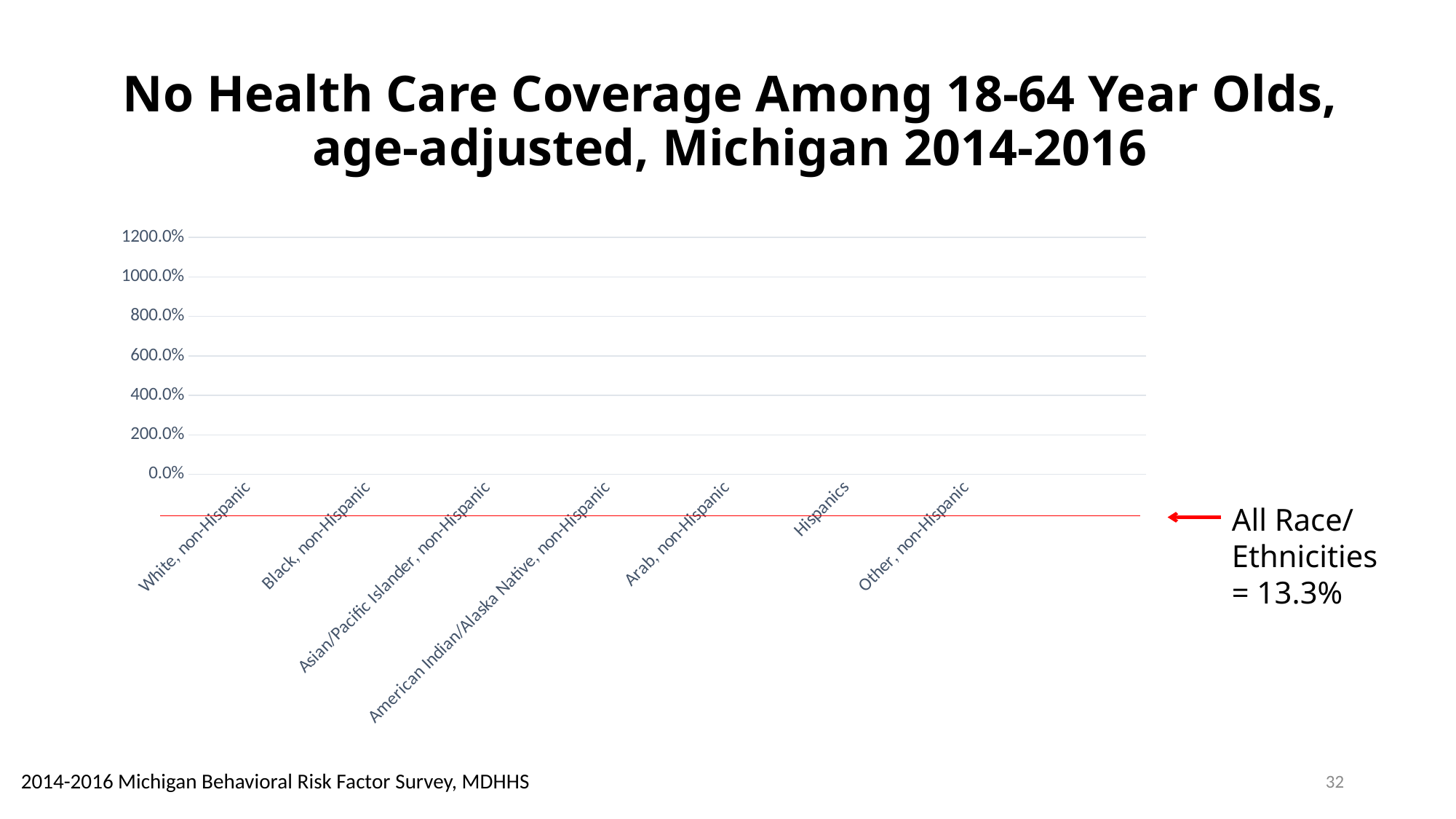
What is the first category listed on the x axis of the chart? White, non-Hispanic What is the title of the chart on the slide? No Health Care Coverage Among 18-64 Year Olds, age-adjusted, Michigan 2014-2016 What is the last category listed on the x axis of the chart? Other, non-Hispanic How many race/ethnicity categories are listed along the x axis of the chart? 7 What value does the red reference line labelled "All Race/Ethnicities" represent? 13.3%